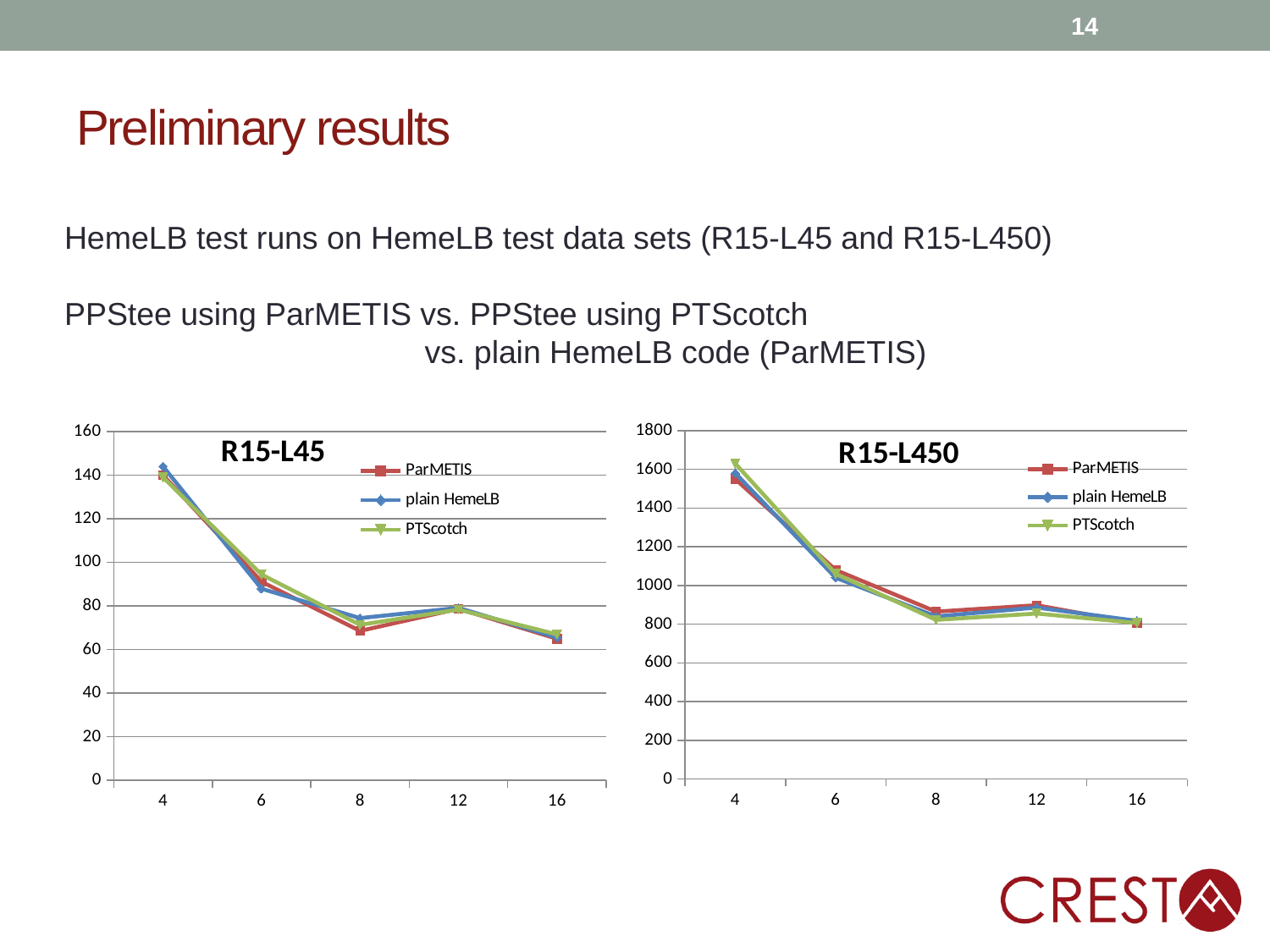
What kind of chart is the R15-L450 chart? line chart How many points along the x axis does the R15-L450 chart have? 5 In the R15-L45 chart, do the values generally rise or fall as the x axis goes from 4 to 16? fall In the R15-L45 chart, is the PTScotch value at x = 6 greater or less than 80? greater In the R15-L450 chart, is the ParMETIS value at x = 6 greater or less than 1000? greater In the R15-L450 chart, do the values generally rise or fall as the x axis goes from 4 to 16? fall Which series is drawn in green in the R15-L450 chart? PTScotch How many series does the legend of the R15-L45 chart list? 3 In the R15-L45 chart, is the ParMETIS value at x = 8 greater or less than 80? less What is the title of the chart on the left of the slide? R15-L45 What kind of chart is the R15-L45 chart? line chart